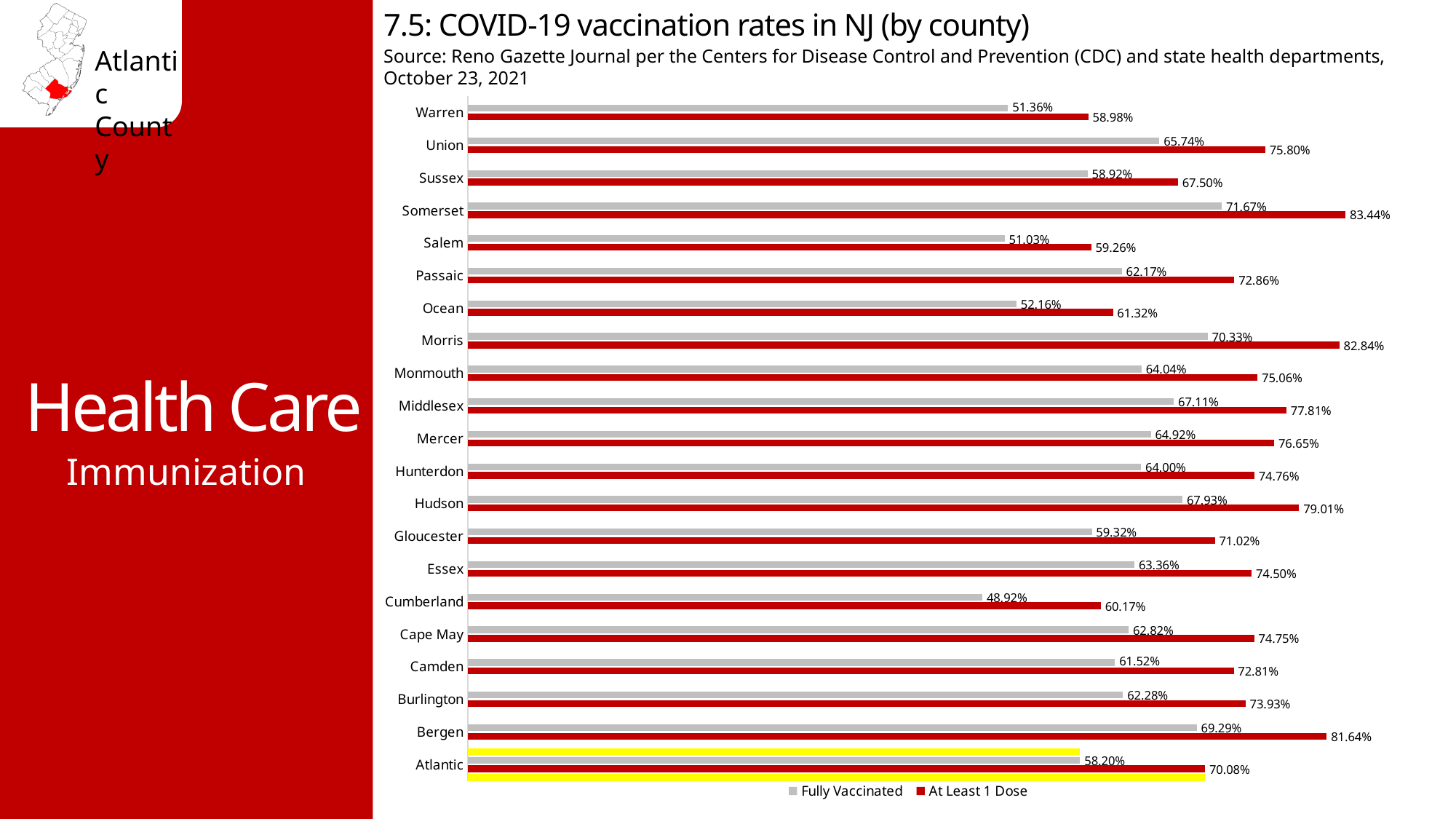
Which county has the lowest At Least 1 Dose rate? Warren Which county has a higher Fully Vaccinated rate, Bergen or Hudson? Bergen What is the difference between the At Least 1 Dose rate and the Fully Vaccinated rate for Atlantic county? 11.88% What is the Fully Vaccinated rate for Atlantic county? 58.20% What is the At Least 1 Dose rate for Cumberland county? 60.17% How many counties are shown in the chart? 21 Which colour represents the At Least 1 Dose series? Red How many series does the legend list? 2 Which county has the lowest Fully Vaccinated rate? Cumberland What kind of chart is shown on the slide? Bar chart Which county has the highest Fully Vaccinated rate? Somerset What is the At Least 1 Dose rate for Somerset county? 83.44%